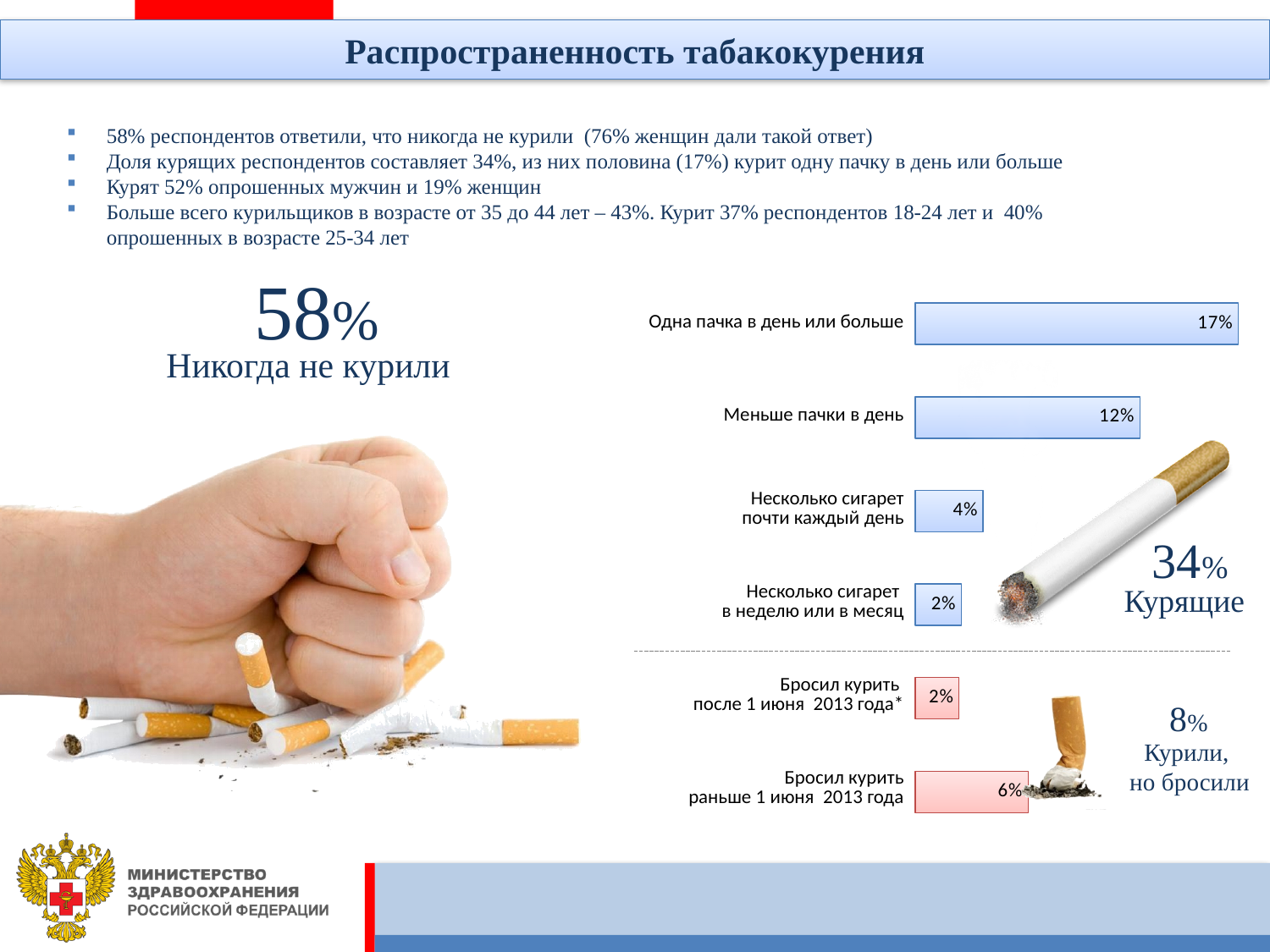
What is the value for "Бросил курить раньше 1 июня 2013 года"? 6% Which category has the highest value in the bar chart? Одна пачка в день или больше What is the value for "Бросил курить после 1 июня 2013 года"? 2% What kind of chart is shown on the slide? Bar chart Which is larger: "Меньше пачки в день" or "Бросил курить раньше 1 июня 2013 года"? Меньше пачки в день What colour are the two "Бросил курить" bars, in contrast to the other bars? Red (pink); the others are blue What is the difference between "Одна пачка в день или больше" and "Меньше пачки в день"? 5% What is the value for "Меньше пачки в день"? 12% What is the value for "Несколько сигарет в неделю или в месяц"? 2% What is the value for "Одна пачка в день или больше"? 17% How many categories (bars) does the bar chart show? 6 What is the value for "Несколько сигарет почти каждый день"? 4%